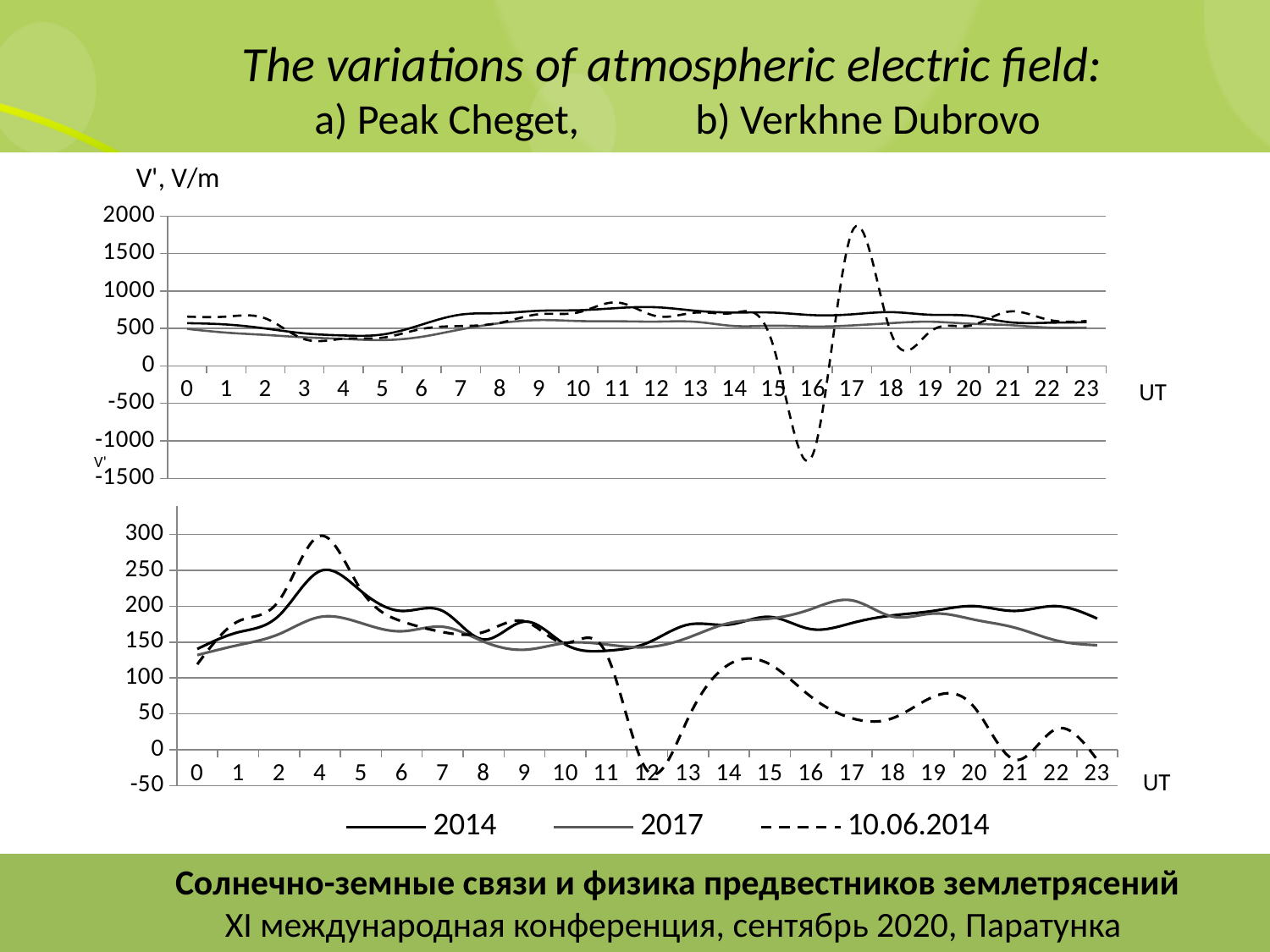
In the top chart (a) Peak Cheget, is the value of the 10.06.2014 series at 16 UT greater or less than -1000? less How many series does the legend list for the charts? 3 Which series in the legend is drawn with a dashed line? 10.06.2014 In the bottom chart (b) Verkhne Dubrovo, is the value of the 10.06.2014 series at 4 UT greater or less than 250? greater In the top chart (a) Peak Cheget, which series reaches the highest value? 10.06.2014 In the bottom chart (b) Verkhne Dubrovo, which is larger at 4 UT: the 2014 series or the 2017 series? 2014 In the top chart (a) Peak Cheget, is the value of the 10.06.2014 series at 17 UT greater or less than 1500? greater How many hourly points (UT) are plotted along the x axis of the bottom chart (b) Verkhne Dubrovo? 23 In the bottom chart (b) Verkhne Dubrovo, which series reaches the highest value? 10.06.2014 In the top chart (a) Peak Cheget, which series reaches the lowest value? 10.06.2014 What kind of chart is the top chart (a) Peak Cheget? line chart